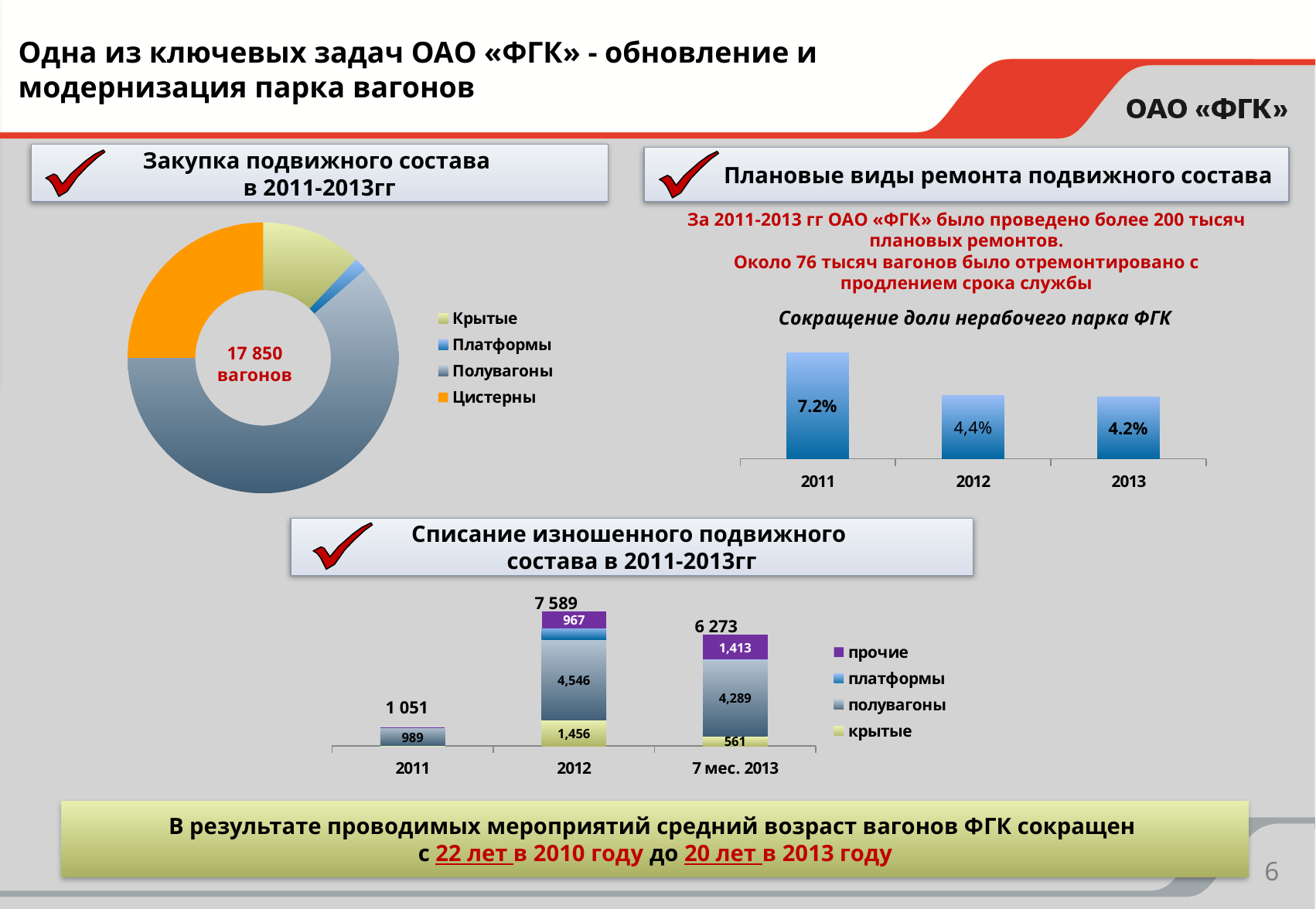
In the stacked bar chart 'Списание изношенного подвижного состава в 2011-2013гг', what is the total for 2012? 7 589 In the chart 'Сокращение доли нерабочего парка ФГК', which year has the highest value? 2011 In the donut chart 'Закупка подвижного состава в 2011-2013гг', which category has the smallest share? Платформы What kind of chart is 'Списание изношенного подвижного состава в 2011-2013гг'? stacked bar chart In the chart 'Сокращение доли нерабочего парка ФГК', do the values rise or fall from 2011 to 2013? fall In the stacked bar chart 'Списание изношенного подвижного состава в 2011-2013гг', what is the value of полувагоны for 7 мес. 2013? 4,289 In the donut chart 'Закупка подвижного состава в 2011-2013гг', what total number of wagons is shown in the centre? 17 850 вагонов In the stacked bar chart 'Списание изношенного подвижного состава в 2011-2013гг', what is the value of крытые for 2012? 1,456 In the chart 'Сокращение доли нерабочего парка ФГК', what is the value for 2011? 7.2% In the chart 'Сокращение доли нерабочего парка ФГК', what is the value for 2013? 4.2% How many categories does the legend of the donut chart 'Закупка подвижного состава в 2011-2013гг' list? 4 In the donut chart 'Закупка подвижного состава в 2011-2013гг', which category has the largest share? Полувагоны